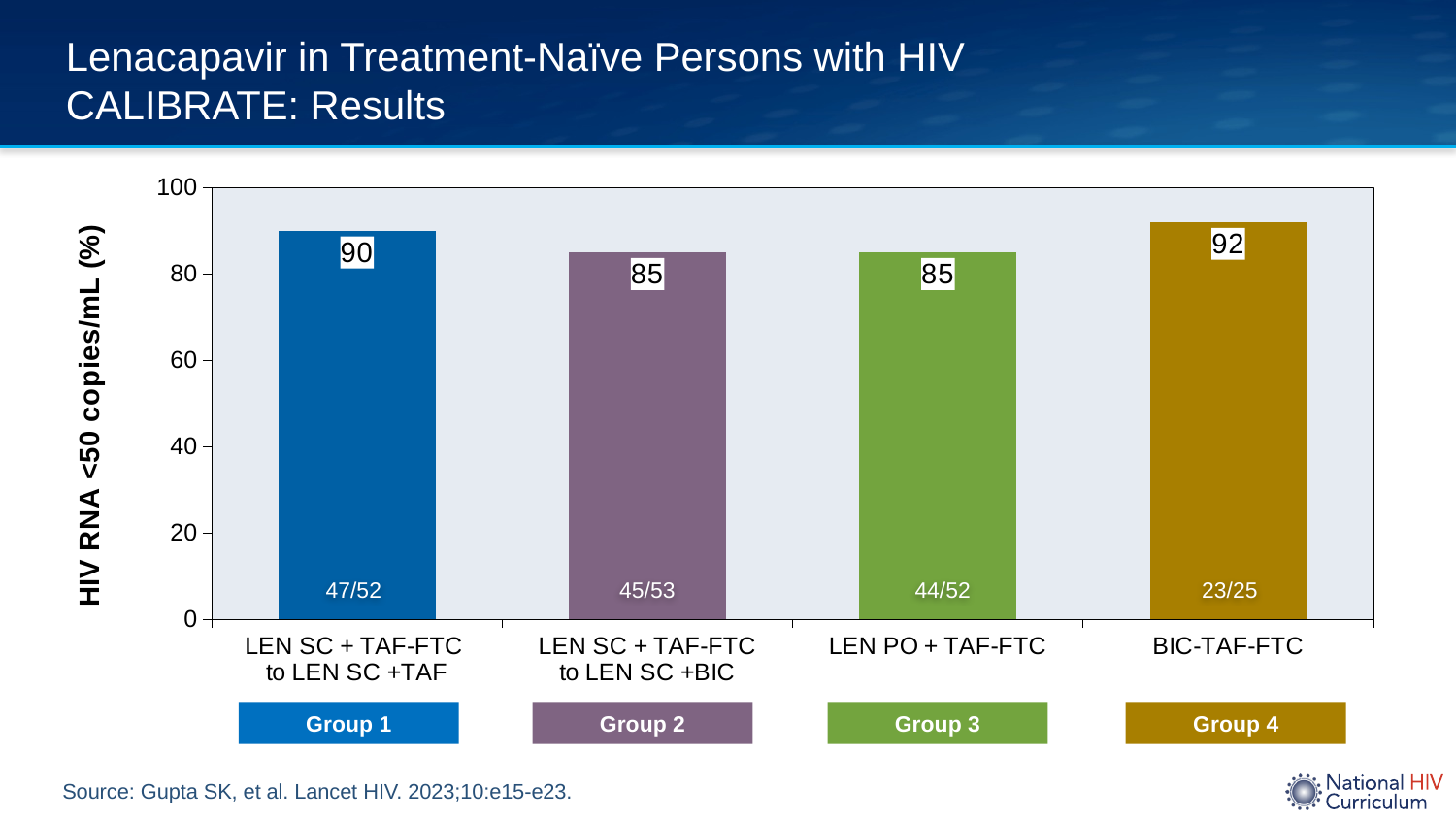
What is the value for Group 4 (BIC-TAF-FTC)? 92 Which group has the highest percentage with HIV RNA <50 copies/mL? Group 4 (BIC-TAF-FTC) What is the difference between the values for Group 4 and Group 1? 2 What fraction is printed inside the bar for Group 4? 23/25 Is the value for Group 2 greater or less than 80? greater What is the value for Group 3 (LEN PO + TAF-FTC)? 85 Which is larger, the value for Group 1 or the value for Group 2? Group 1 How many groups are shown in the chart? 4 What is the value for Group 1 (LEN SC + TAF-FTC to LEN SC +TAF)? 90 What is the difference between the values for Group 1 and Group 2? 5 What is the label of the y-axis? HIV RNA <50 copies/mL (%) What kind of chart is shown on the slide? Bar chart